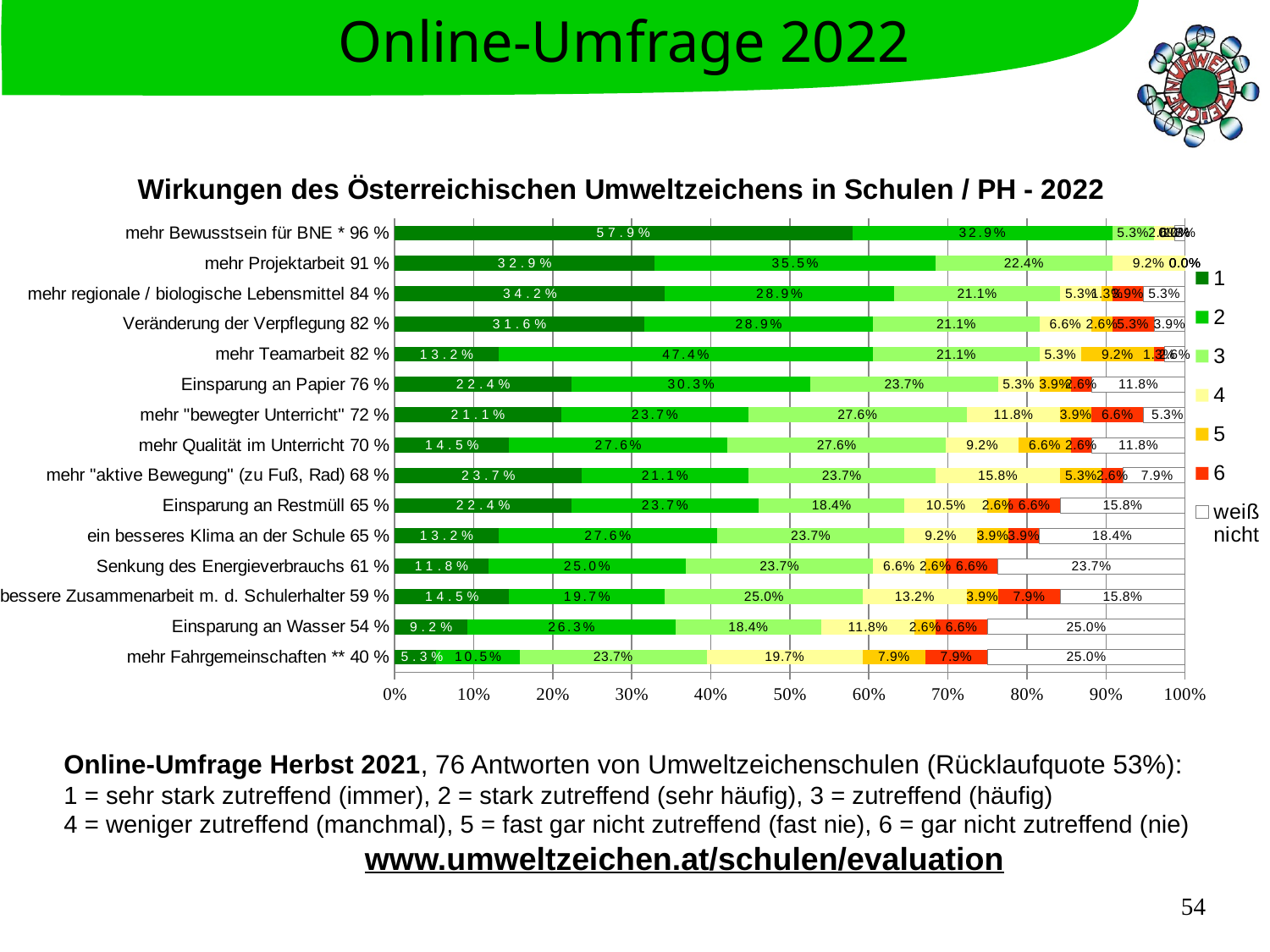
What is the value of "weiß nicht" for "Einsparung an Wasser 54 %"? 25.0% How many series does the legend list? 7 Which category has the highest value for series 1? mehr Bewusstsein für BNE * 96 % What is the value of series 1 for "mehr Bewusstsein für BNE * 96 %"? 57.9% What is the value of series 2 for "mehr Teamarbeit 82 %"? 47.4% What is the difference between series 1 and series 2 for "mehr Bewusstsein für BNE * 96 %"? 25.0% What is the value of series 3 for "mehr Fahrgemeinschaften ** 40 %"? 23.7% What kind of chart is shown on the slide? stacked bar chart How many categories (rows) does the chart show? 15 Which category has the lowest value for series 1? mehr Fahrgemeinschaften ** 40 % Which is larger for "mehr Projektarbeit 91 %": series 1 or series 2? series 2 What is the title of the chart? Wirkungen des Österreichischen Umweltzeichens in Schulen / PH - 2022